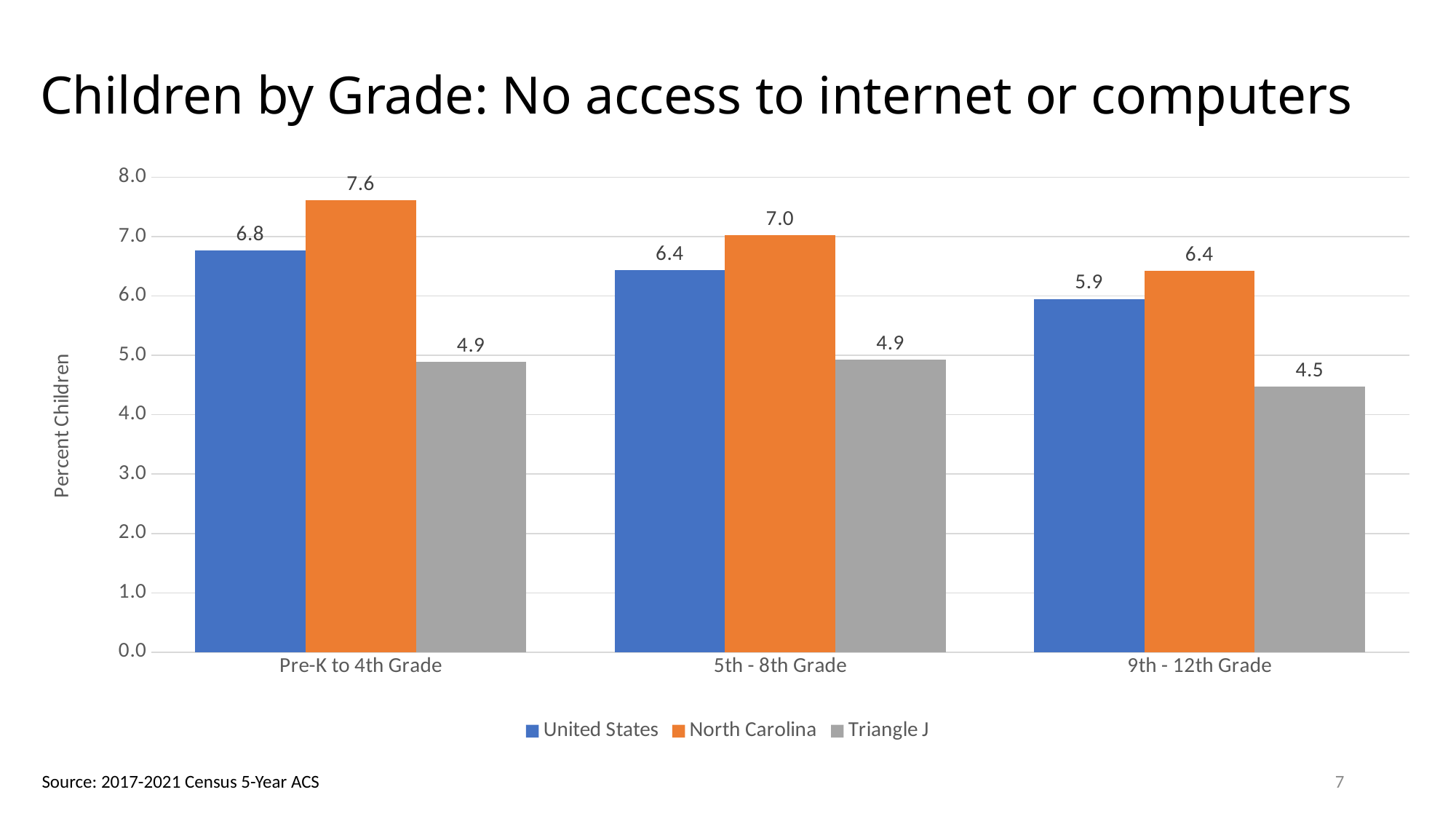
What is the value for Triangle J in the 9th - 12th Grade category? 4.5 How many series does the legend list? 3 What is the value for North Carolina in the Pre-K to 4th Grade category? 7.6 What is the value for United States in the 5th - 8th Grade category? 6.4 Which grade category has the highest value for North Carolina? Pre-K to 4th Grade How many grade categories are shown on the x axis? 3 What is the difference between the North Carolina and Triangle J values in the Pre-K to 4th Grade category? 2.7 What kind of chart is shown on the slide? bar chart Is the value for Triangle J in the 5th - 8th Grade category greater or less than 5.0? less Which is larger in the 5th - 8th Grade category: the United States value or the North Carolina value? North Carolina What is the difference between the United States values for Pre-K to 4th Grade and 9th - 12th Grade? 0.9 Which grade category has the lowest value for Triangle J? 9th - 12th Grade